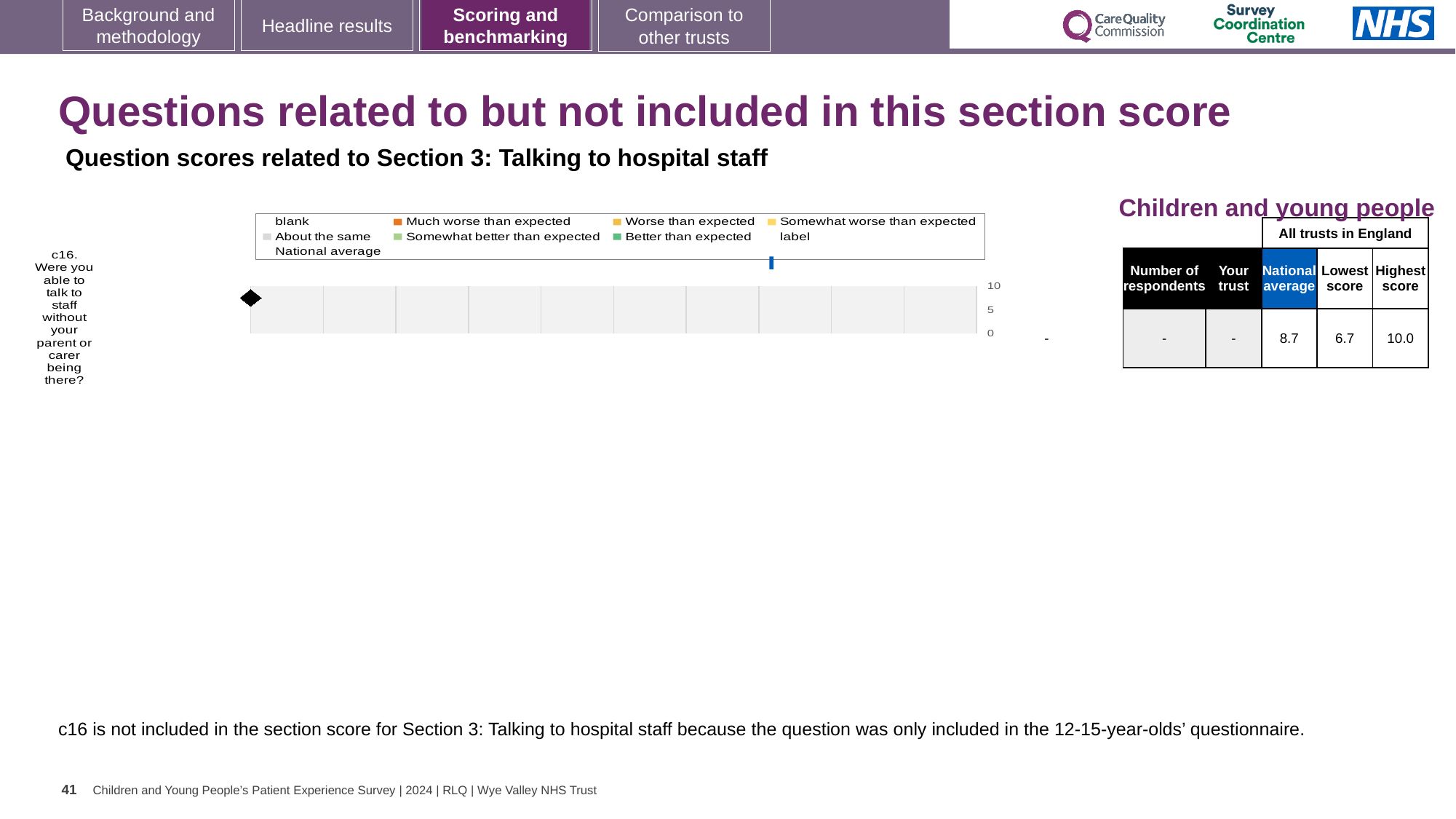
In the table next to the chart, is the National average for c16 greater or less than 5? greater Which question number is the category on the chart labelled with? c16 What is the highest value shown on the chart's vertical axis? 10 What kind of chart is shown on the slide? bar chart In the table next to the chart, what is the difference between the Highest score and the Lowest score for c16? 3.3 In the table next to the chart, what is shown for Your trust score for c16? - In the table next to the chart, what is the National average score for c16? 8.7 In the table next to the chart, what is the Lowest score for c16 across all trusts in England? 6.7 In the table next to the chart, what is the Highest score for c16 across all trusts in England? 10.0 How many question categories are plotted on the chart? 1